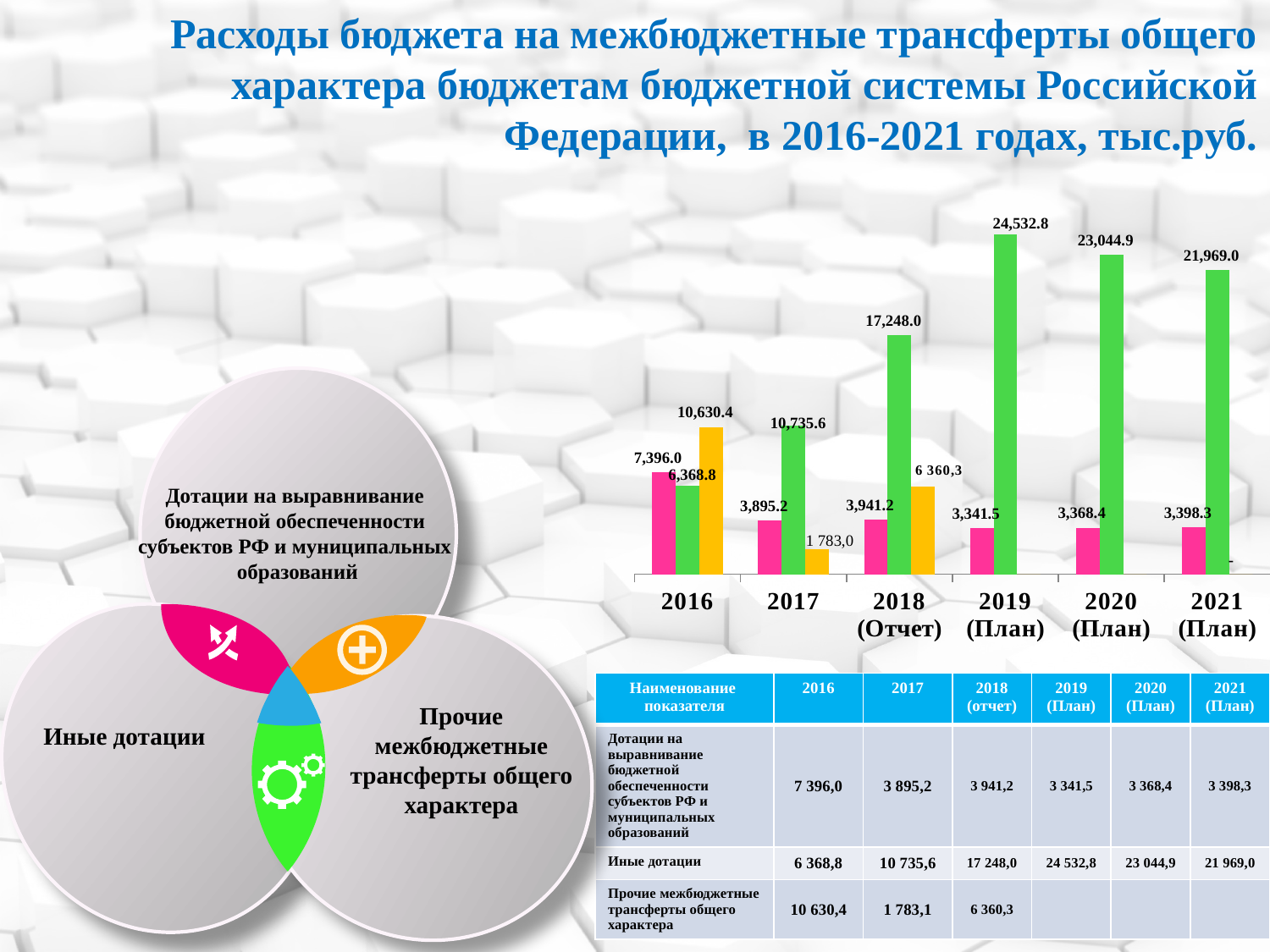
In which year does the green series (Иные дотации) reach its highest value? 2019 (План) What is the value of the green bar (Иные дотации) for 2019 (План)? 24,532.8 What is the value of the green bar for 2018 (Отчет)? 17,248.0 What is the value of the pink bar (Дотации на выравнивание бюджетной обеспеченности) for 2016? 7,396.0 In which year is the pink series (Дотации на выравнивание) at its lowest value? 2019 (План) How many years (categories) are shown on the x axis of the bar chart? 6 Which is larger in 2016: the pink bar or the green bar? the pink bar (7,396.0) What is the value of the yellow bar (Прочие межбюджетные трансферты общего характера) for 2016? 10,630.4 What is the difference between the green bar values for 2019 (План) and 2020 (План)? 1,487.9 What type of chart is shown on the slide? bar chart Does the green series (Иные дотации) rise or fall from 2016 to 2019? rise What is the difference between the green bar values for 2018 (Отчет) and 2017? 6,512.4